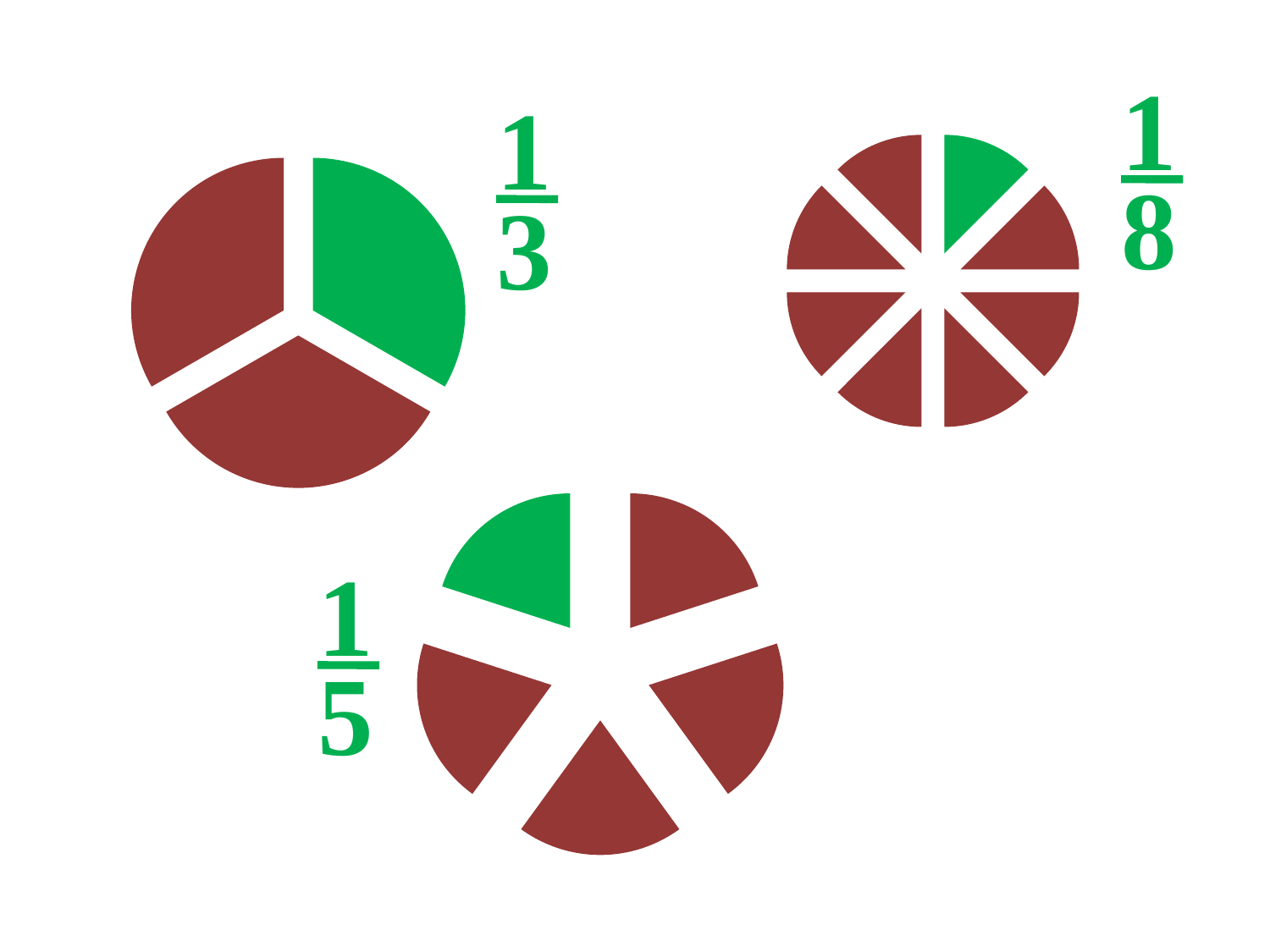
How many slices does the bottom pie chart have? 5 What fraction of the top-right pie chart is shown in green, according to the label next to it? 1/8 Which pie chart on the slide has the most slices: the top-left, the top-right, or the bottom one? top-right What kind of chart is the top-left chart on the slide? pie chart How many green slices does the top-right pie chart have? 1 How many slices does the top-right pie chart have? 8 What fraction of the top-left pie chart is shown in green, according to the label next to it? 1/3 What fraction of the bottom pie chart is shown in green, according to the label next to it? 1/5 Which pie chart on the slide has the fewest slices: the top-left, the top-right, or the bottom one? top-left What colour are the slices in the bottom pie chart that are not green? dark red